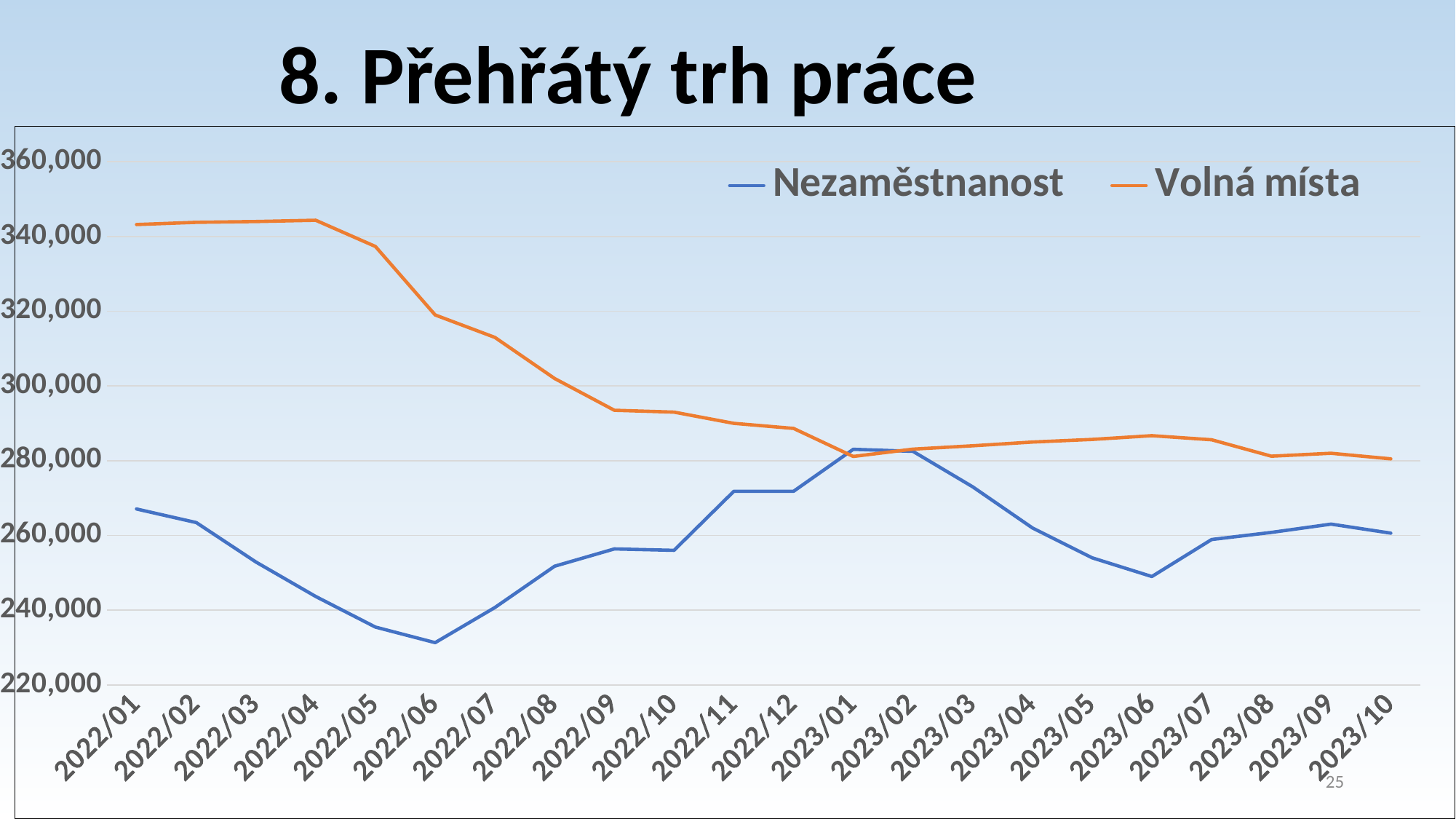
Is the value for Nezaměstnanost in 2022/11 greater or less than 260,000? greater How many months (points) are shown on the x axis? 22 In 2023/06, which series has the higher value, Nezaměstnanost or Volná místa? Volná místa Is the value for Volná místa in 2022/09 greater or less than 300,000? less In 2022/01, which series has the higher value, Nezaměstnanost or Volná místa? Volná místa In which month is Nezaměstnanost at its lowest? 2022/06 What kind of chart is shown on the slide? line chart What colour is the Nezaměstnanost line? blue Is the value for Nezaměstnanost in 2022/06 greater or less than 240,000? less Does Volná místa rise or fall between 2022/04 and 2022/09? fall How many series does the legend list? 2